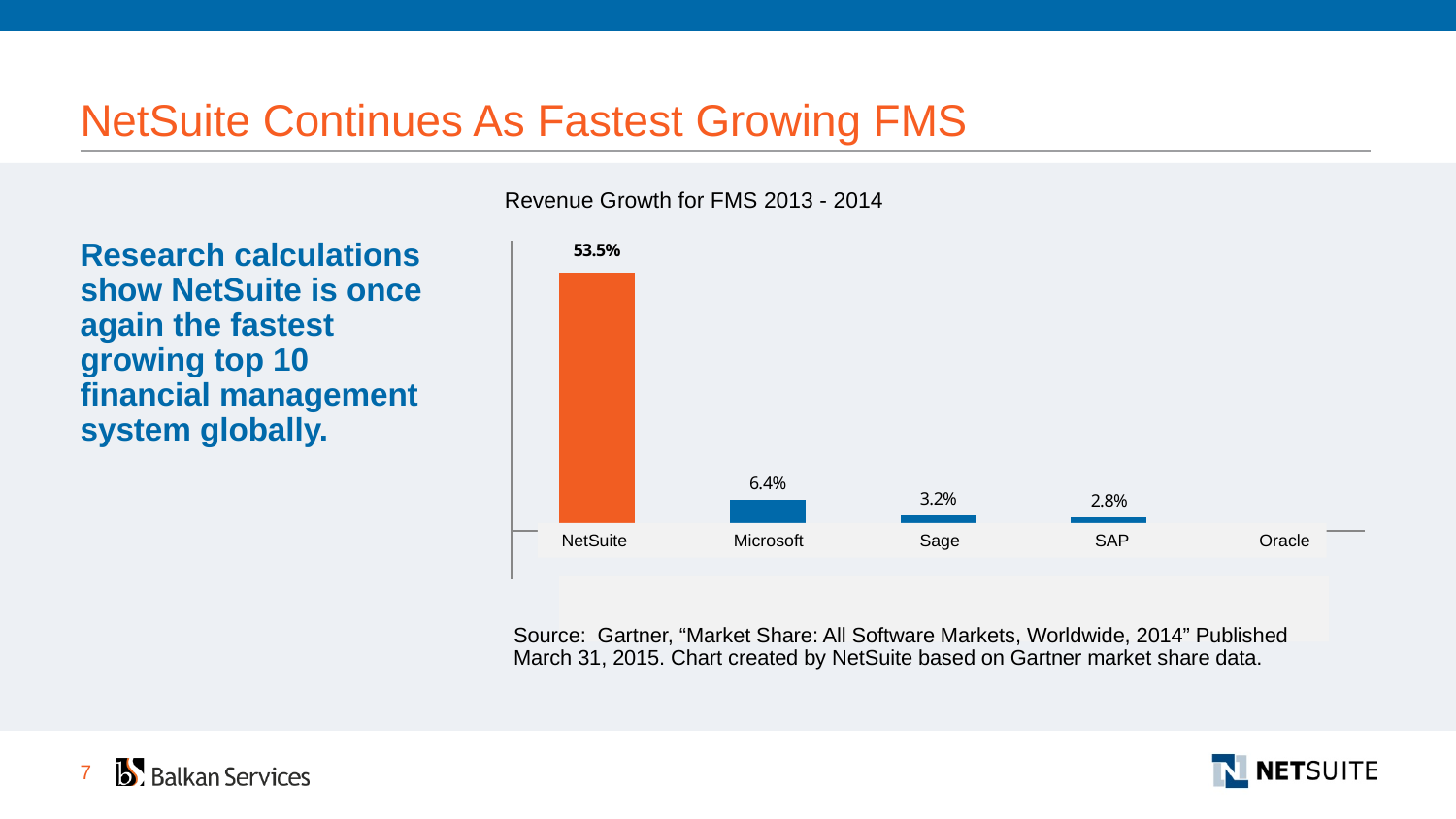
Which company has the highest revenue growth in the chart? NetSuite What is the title of the chart? Revenue Growth for FMS 2013 - 2014 Which company has the lowest revenue growth in the chart? Oracle What is the revenue growth value shown for SAP? 2.8% What is the difference between Microsoft's and Sage's revenue growth? 3.2% What is the difference between NetSuite's and Microsoft's revenue growth? 47.1% What is the revenue growth value shown for Microsoft? 6.4% How many companies are shown on the x axis of the chart? 5 What is the revenue growth value shown for Sage? 3.2% What kind of chart is shown on the slide? Bar chart Which has higher revenue growth, Microsoft or SAP? Microsoft What is the revenue growth value shown for NetSuite? 53.5%